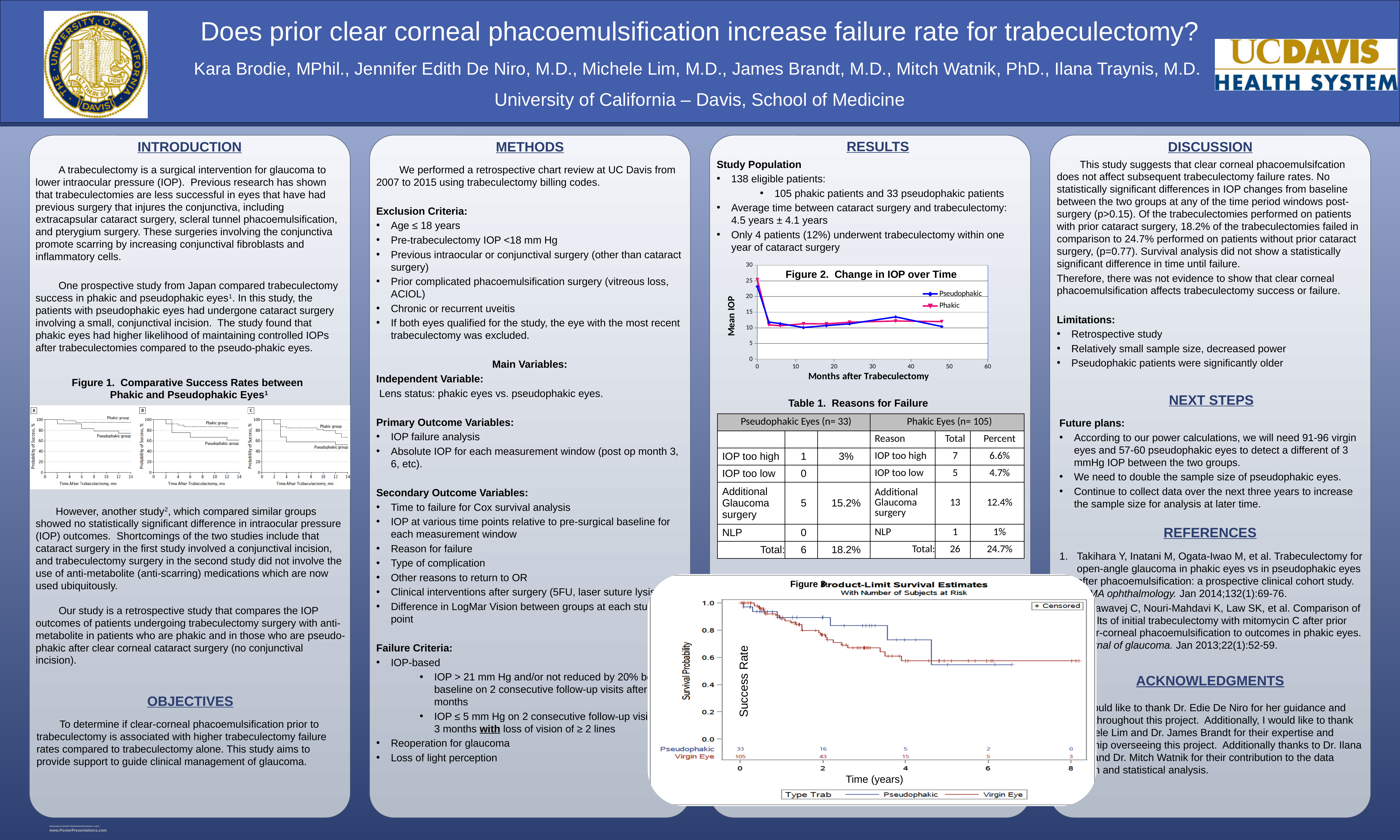
What kind of chart is Figure 2, Change in IOP over Time? line chart In Figure 3, the Product-Limit Survival Estimates plot, how many Virgin Eye subjects are at risk at 4 years? 15 In Figure 2, Change in IOP over Time, is the Pseudophakic value at month 0 greater or less than 20? greater In Figure 2, Change in IOP over Time, does the Pseudophakic mean IOP rise or fall between month 0 and month 3? fall In Figure 2, Change in IOP over Time, is the Pseudophakic value at month 48 greater or less than 15? less In Figure 3, the Product-Limit Survival Estimates plot, how many Pseudophakic subjects are at risk at 2 years? 16 In Figure 2, Change in IOP over Time, how many series does the legend list? 2 In Figure 2, Change in IOP over Time, which series has the higher mean IOP at month 0, Pseudophakic or Phakic? Phakic In Figure 2, Change in IOP over Time, is the Phakic value at month 36 greater or less than 15? less In Figure 3, the Product-Limit Survival Estimates plot, how many Virgin Eye subjects are at risk at time 0? 105 In Figure 2, Change in IOP over Time, what are the two series named in the legend? Pseudophakic and Phakic In Figure 2, Change in IOP over Time, what is the title of the x axis? Months after Trabeculectomy